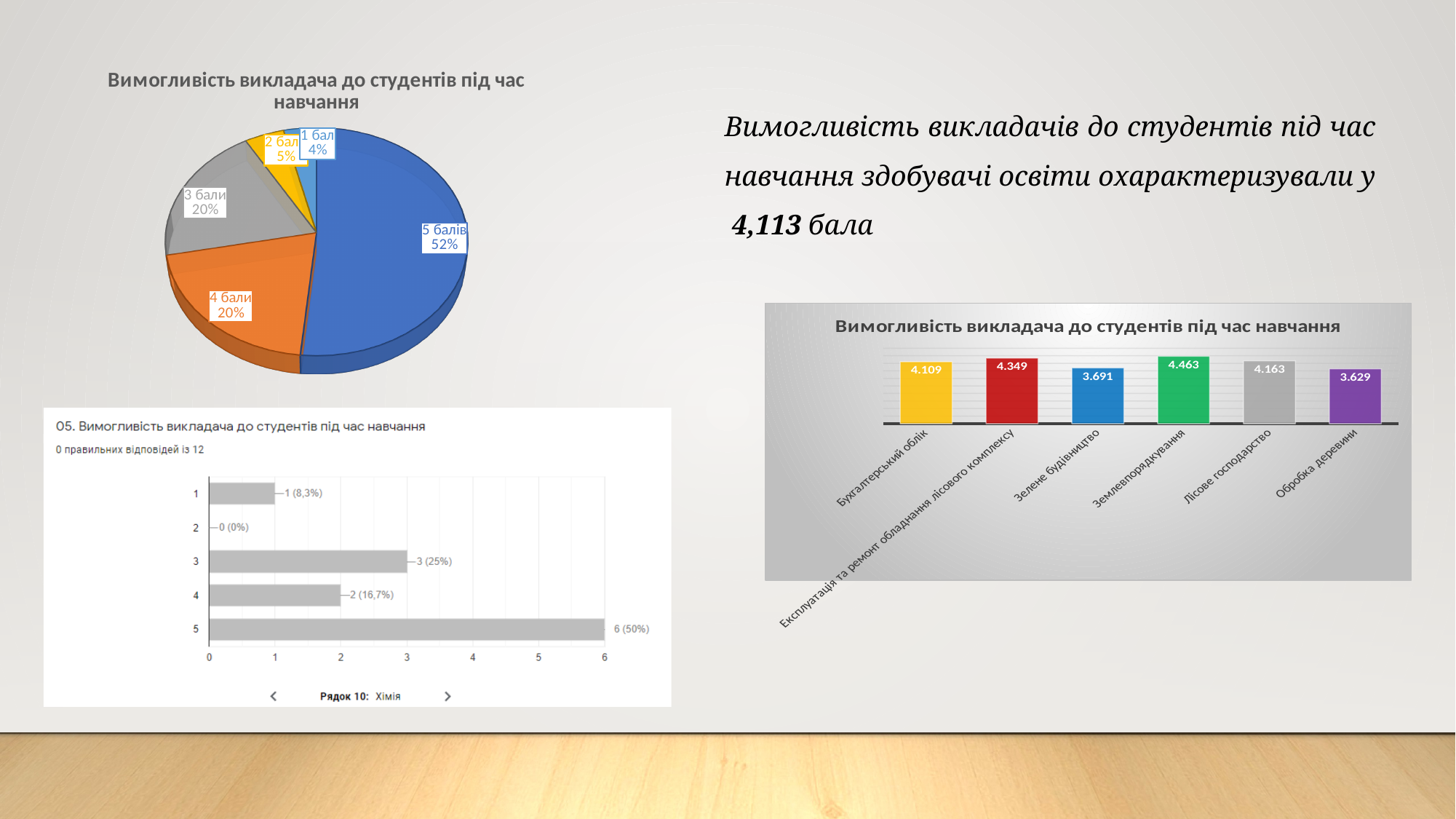
In the pie chart at the top left, what share of responses is '1 бал'? 4% In the pie chart at the top left, what share of responses is '5 балів'? 52% In the bottom-left bar chart, which category has the lowest value? 2 In the right-hand bar chart, which category has the lowest value? Обробка деревини In the bottom-left bar chart, what is the value for category 4? 2 (16,7%) In the right-hand bar chart, what is the value for Землевпорядкування? 4.463 In the right-hand bar chart, how many categories are shown? 6 In the bottom-left bar chart, what is the value for category 5? 6 (50%) In the pie chart at the top left, how many slices are there? 5 What kind of chart is the bottom-left chart? Bar chart In the right-hand bar chart, which is larger: Бухгалтерський облік or Лісове господарство? Лісове господарство In the pie chart at the top left, which category has the largest slice? 5 балів